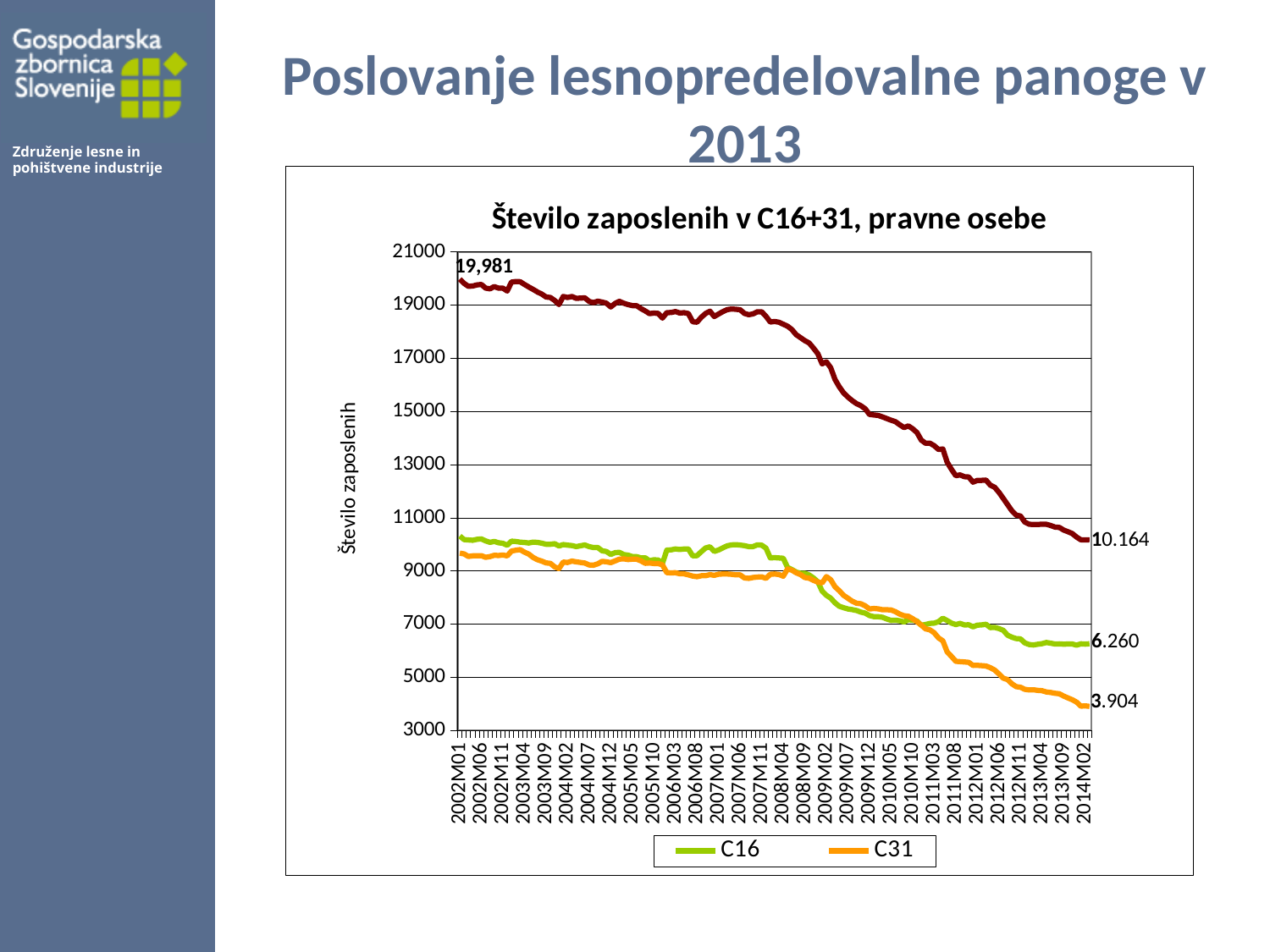
Is the value of the C31 series at 2014M02 greater or less than 5000? less What kind of chart is shown on the slide? line chart What is the final labelled value of the C16 series at the right end of the chart? 6.260 What is the title of the chart? Število zaposlenih v C16+31, pravne osebe Do the values of the C16 series rise or fall over the period shown? fall Which series has the higher value at the end of the chart, C16 or C31? C16 What is the labelled value at the start of the top (dark red) line in 2002M01? 19,981 Is the value of the C16 series at 2002M01 greater or less than 9000? greater How many series does the chart legend list? 2 What is the label of the y axis? Število zaposlenih What is the final labelled value of the C31 series at the right end of the chart? 3.904 What is the labelled value at the end of the top (dark red) line in 2014M02? 10.164